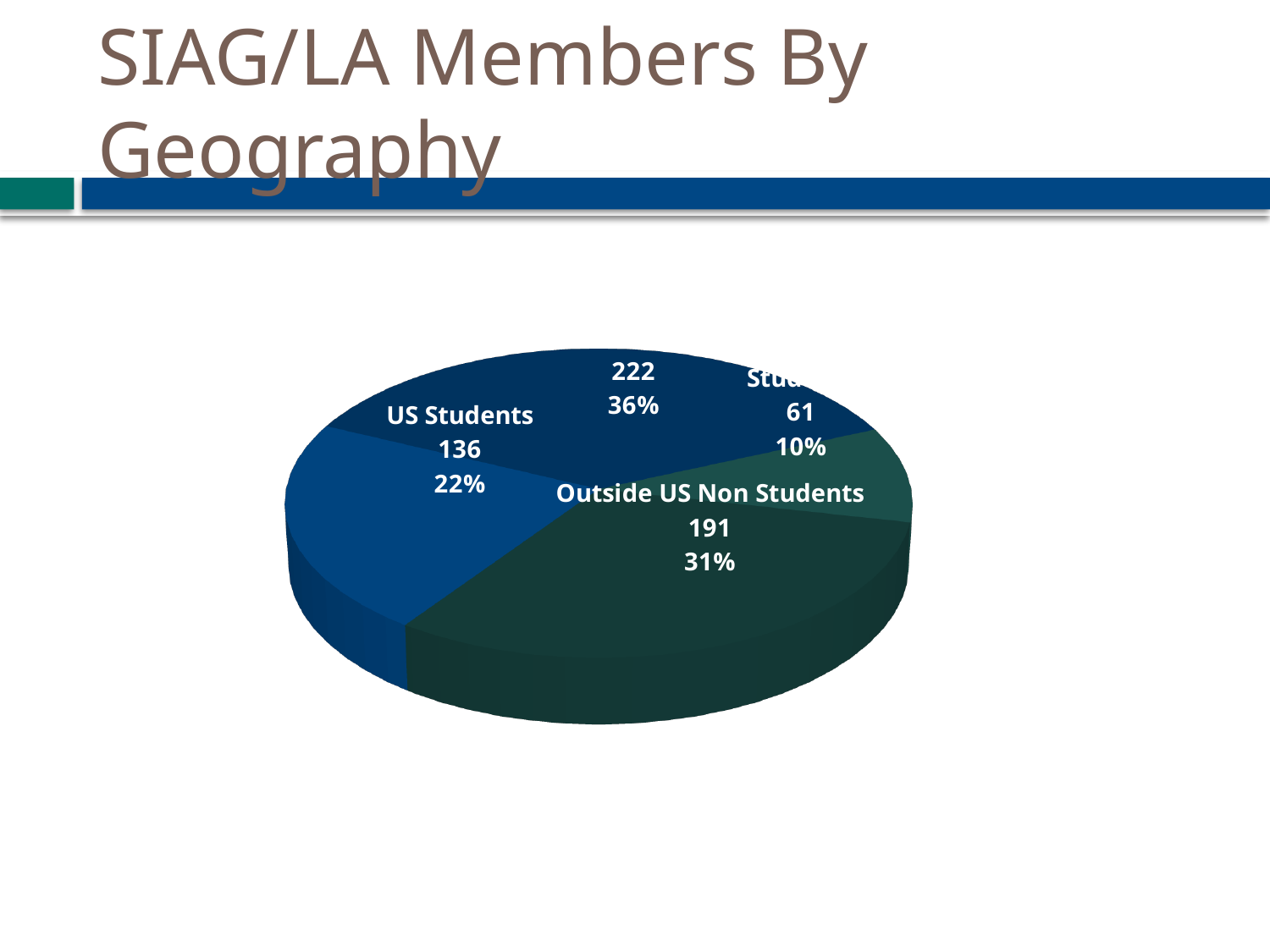
How many members are in the Outside US Non Students slice? 191 What is the member count of the largest slice in the pie chart? 222 What is the total number of members across all four slices of the pie chart? 610 Which is larger, the US Students slice or the Outside US Non Students slice? Outside US Non Students What share of the pie does the Outside US Non Students slice represent? 31% What is the member count of the smallest slice in the pie chart? 61 What share of the pie does the US Students slice represent? 22% How many members are in the US Students slice? 136 What is the title of the slide containing the chart? SIAG/LA Members By Geography What is the difference in members between the Outside US Non Students slice and the US Students slice? 55 How many slices does the pie chart have? 4 What kind of chart is shown on the slide? pie chart